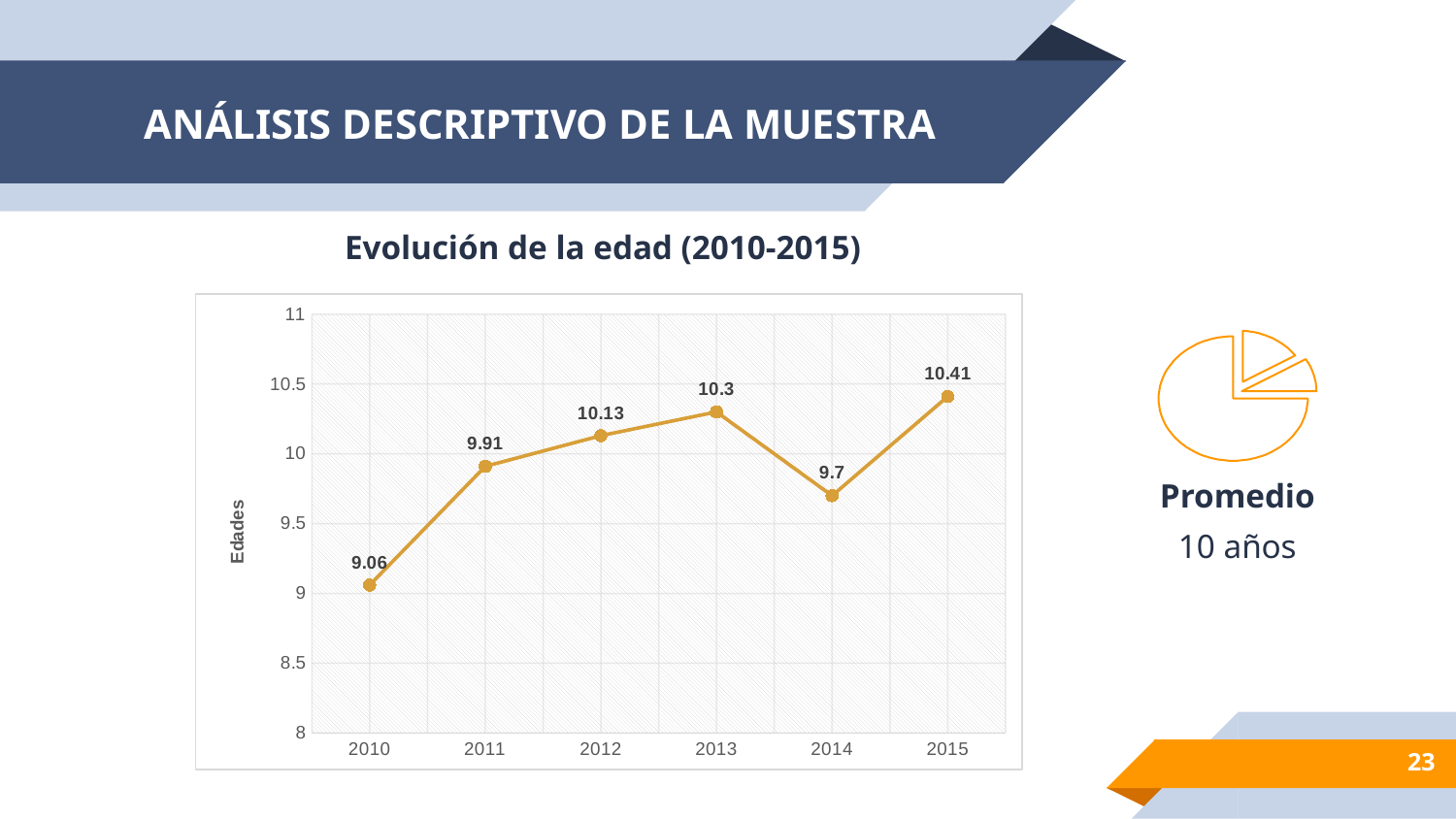
Which year has the highest value? 2015 Which year has the lowest value? 2010 What is the difference between the values for 2015 and 2010? 1.35 What kind of chart is shown on the slide? line chart Is the value for 2011 greater or less than 10? less How many data points are plotted on the chart? 6 What is the value for 2014? 9.7 What is the difference between the values for 2013 and 2014? 0.6 What is the value for 2010? 9.06 What is the value for 2013? 10.3 Which is larger, the value for 2012 or the value for 2014? 2012 What is the title of the chart? Evolución de la edad (2010-2015)